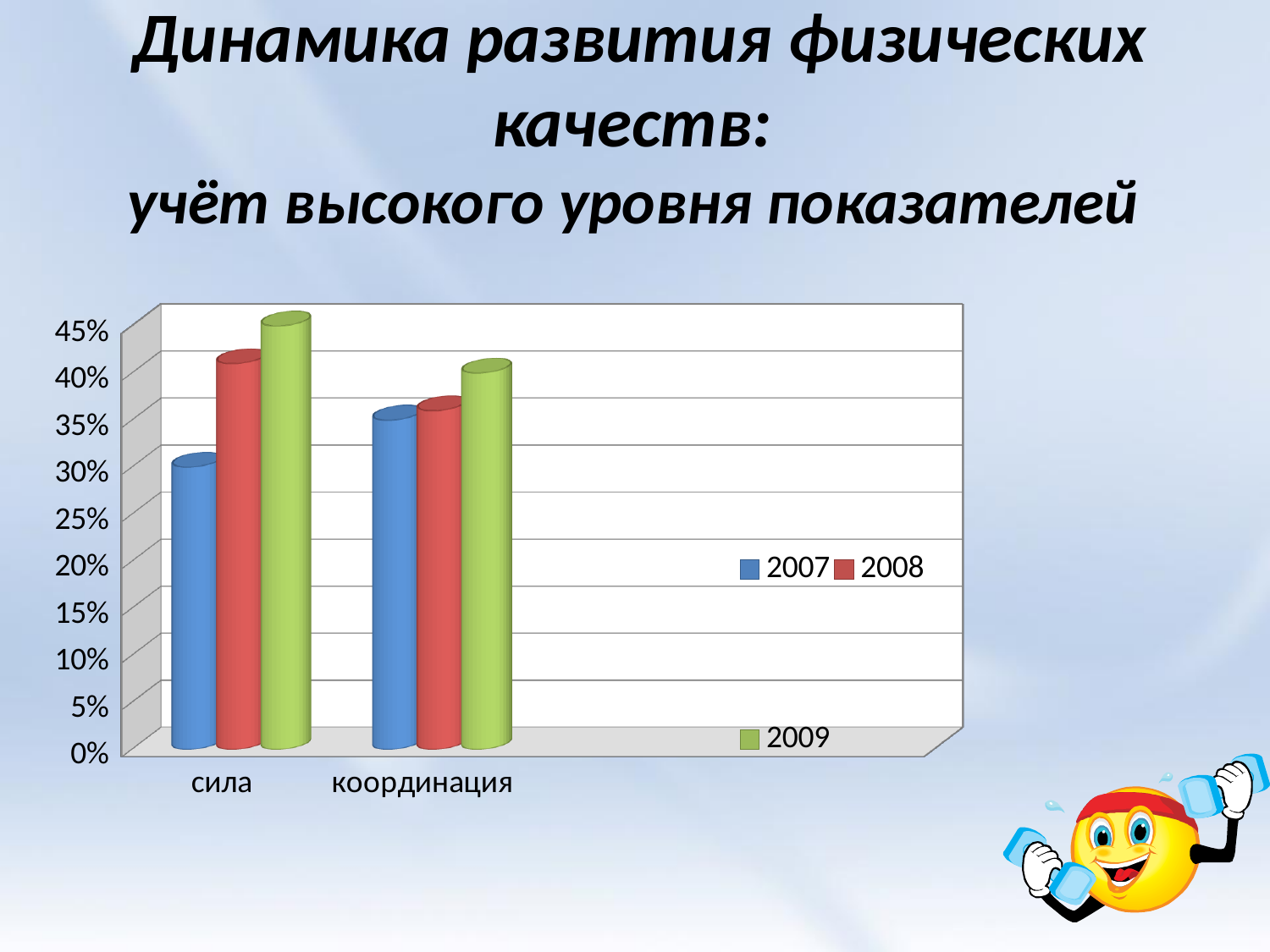
Which is larger for 2009: the value for сила or the value for координация? сила Which series are listed in the chart's legend? 2007, 2008, 2009 Is the value for координация in 2009 greater or less than 35%? greater Do the values for сила rise or fall from 2007 to 2009? rise Which is larger for 2007: the value for сила or the value for координация? координация Which year has the lowest value for сила? 2007 How many categories are shown on the x axis of the chart? 2 How many series does the chart's legend list? 3 Is the value for сила in 2009 greater or less than 40%? greater Is the value for сила in 2007 greater or less than 35%? less Which year has the highest value for сила? 2009 What kind of chart is shown on the slide? bar chart